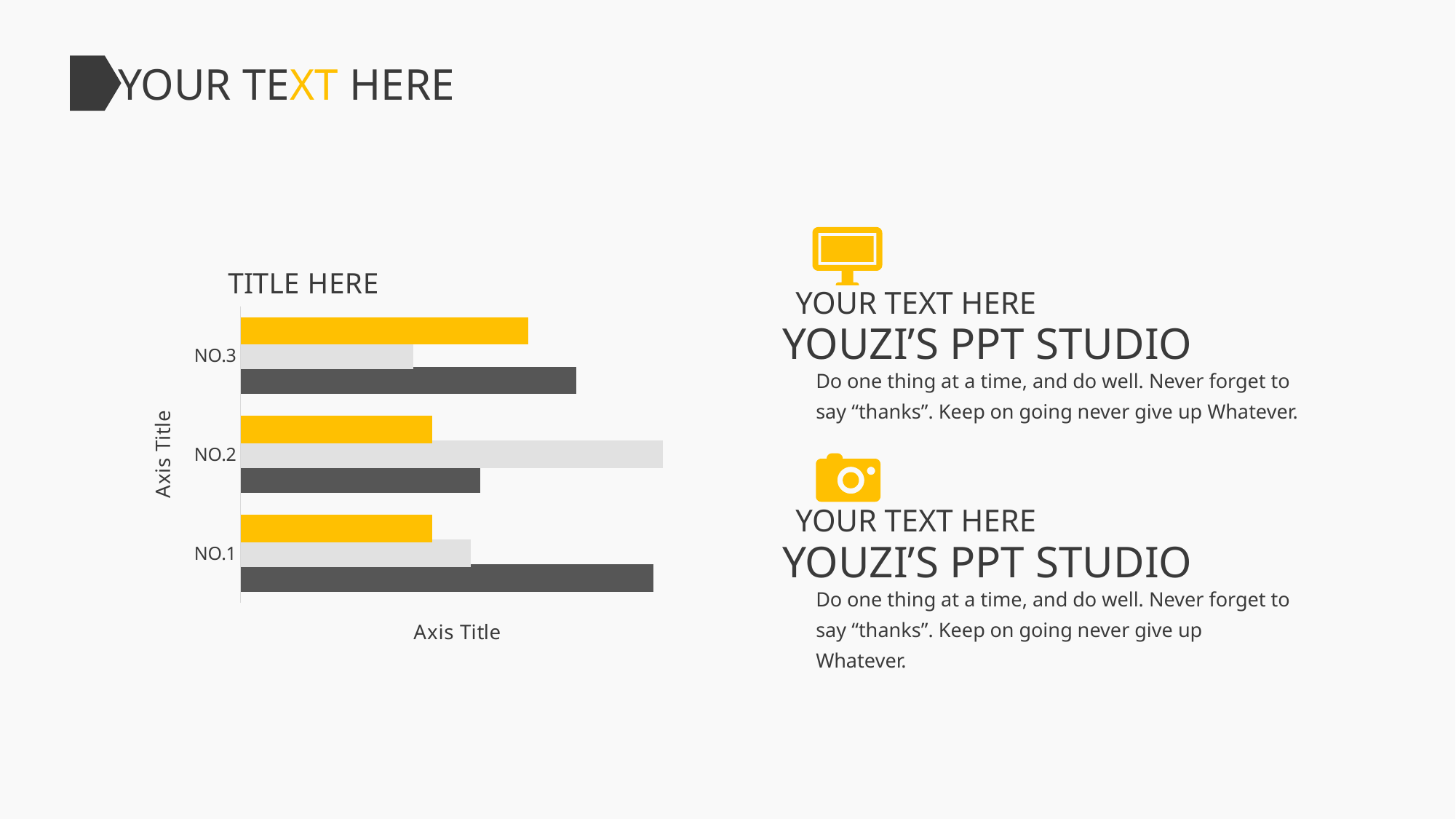
How many bars are plotted for each category in the chart? 3 Which category has the shortest dark gray bar? NO.2 For NO.2, which bar is longer: the yellow bar or the light gray bar? light gray Which category has the shortest light gray bar? NO.3 Which category has the longest light gray bar? NO.2 For NO.1, which bar is longer: the yellow bar or the dark gray bar? dark gray What kind of chart is shown on the slide? bar chart How many categories are shown on the chart's vertical axis? 3 What is the title of the chart? TITLE HERE Which category has the longest yellow bar? NO.3 Which category has the longest dark gray bar? NO.1 What is the label of the horizontal axis of the chart? Axis Title